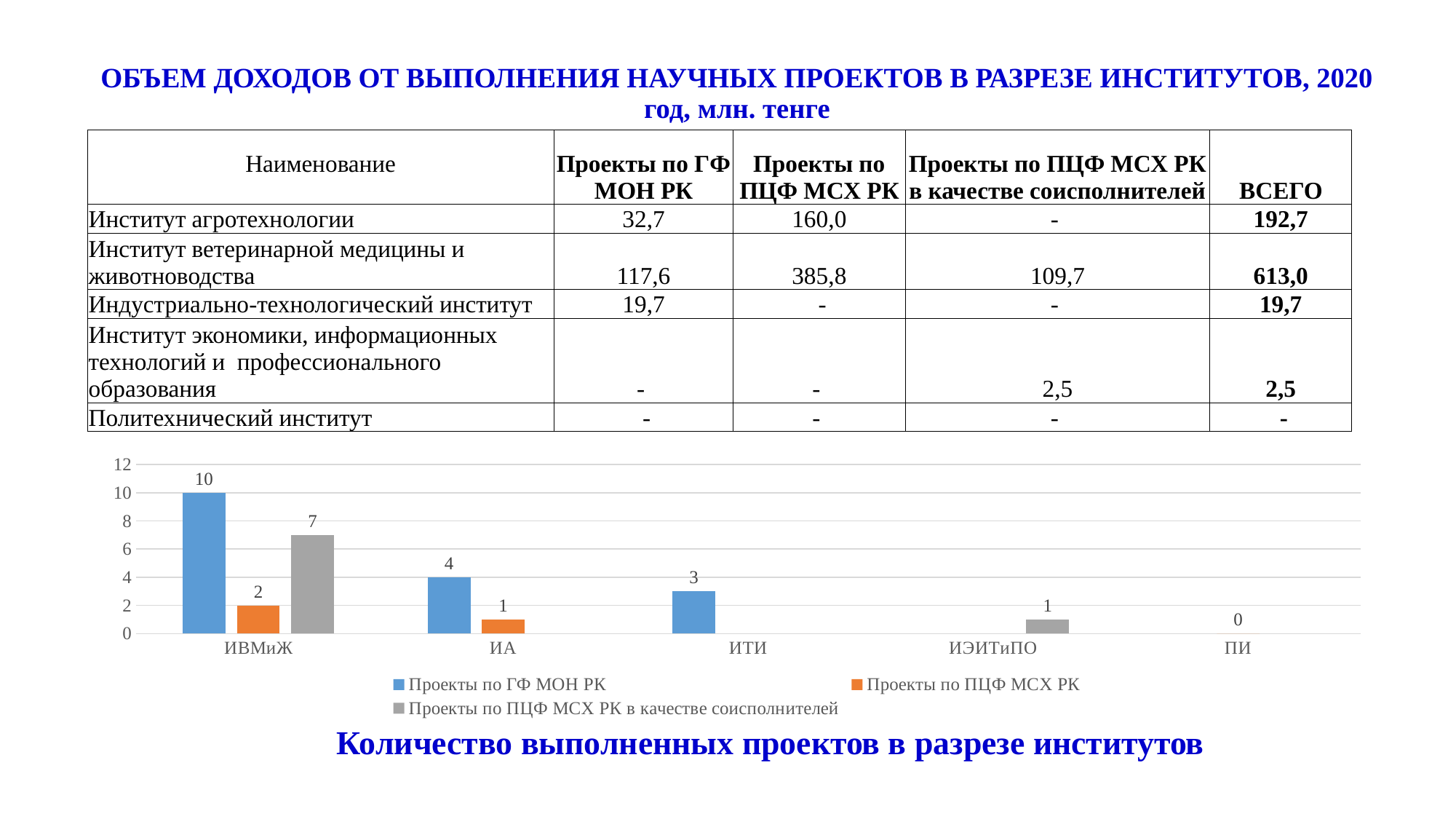
What is the difference between the Проекты по ГФ МОН РК values for ИВМиЖ and ИА? 6 How many series does the chart legend list? 3 What is the value for ИВМиЖ in the series Проекты по ПЦФ МСХ РК в качестве соисполнителей? 7 Which category has the highest value in the series Проекты по ГФ МОН РК? ИВМиЖ What colour are the bars for the series Проекты по ПЦФ МСХ РК? orange Which is larger for ИВМиЖ: the value for Проекты по ПЦФ МСХ РК or the value for Проекты по ПЦФ МСХ РК в качестве соисполнителей? Проекты по ПЦФ МСХ РК в качестве соисполнителей What is the value shown for ПИ in the chart? 0 What is the value for ИВМиЖ in the series Проекты по ГФ МОН РК? 10 What type of chart is shown on the slide? bar chart What is the value for ИТИ in the series Проекты по ГФ МОН РК? 3 What is the value for ИА in the series Проекты по ПЦФ МСХ РК? 1 How many categories (institutes) are shown on the x axis of the chart? 5